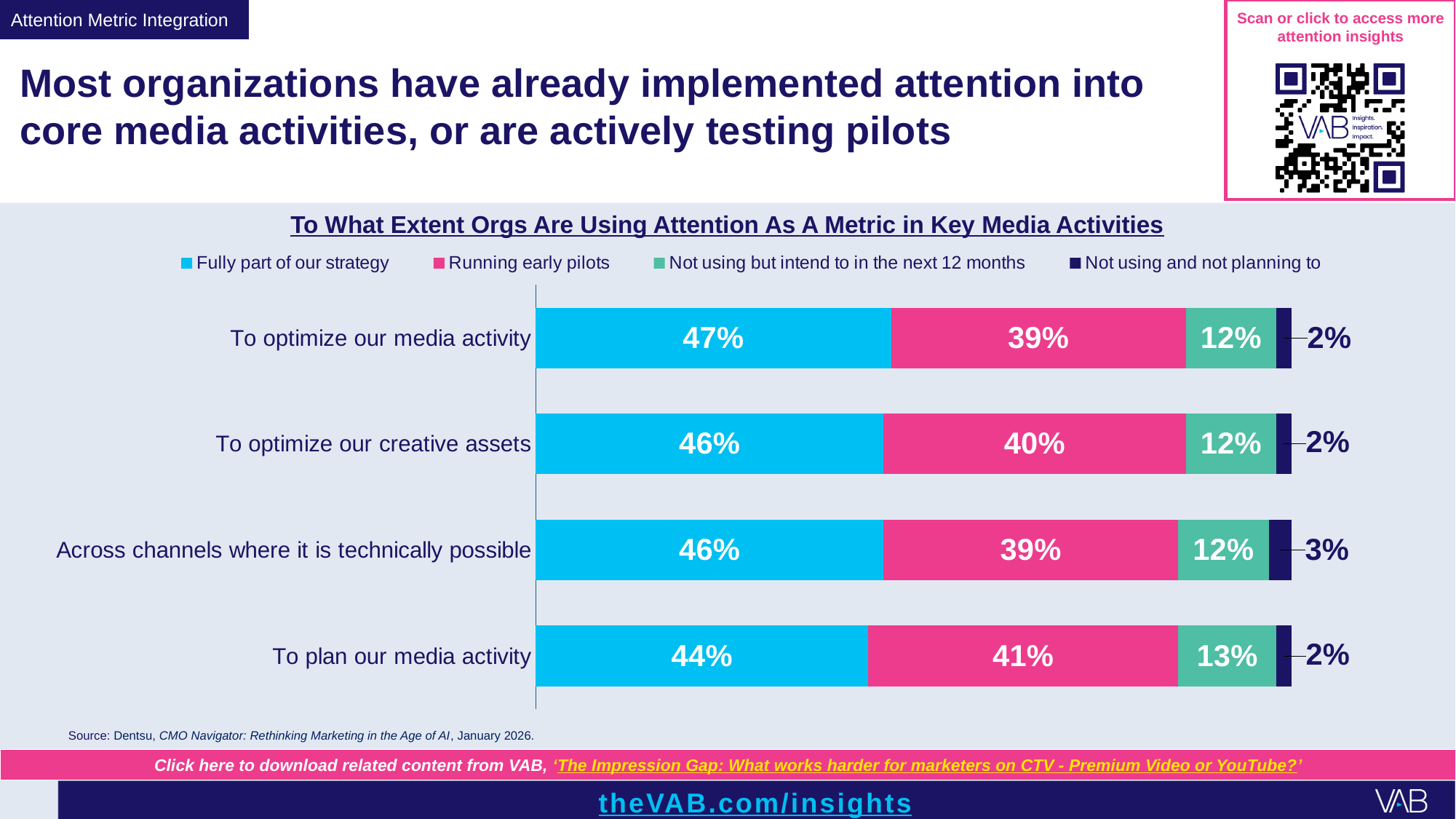
How many media activities (categories) are shown in the chart? 4 What kind of chart is shown on the slide? Stacked bar chart Which media activity has the highest 'Fully part of our strategy' percentage? To optimize our media activity What is the total of the stacked bar for 'To plan our media activity'? 100% What is the difference between the 'Fully part of our strategy' and 'Running early pilots' values for 'To optimize our media activity'? 8% What is the title of the chart? To What Extent Orgs Are Using Attention As A Metric in Key Media Activities What is the 'Running early pilots' value for 'To plan our media activity'? 41% For 'To optimize our creative assets', which is larger: 'Fully part of our strategy' or 'Running early pilots'? Fully part of our strategy Which media activity has the lowest 'Fully part of our strategy' percentage? To plan our media activity What is the 'Not using and not planning to' value for 'Across channels where it is technically possible'? 3% How many series does the legend list? 4 What percentage of organizations say attention is 'Fully part of our strategy' for 'To optimize our media activity'? 47%